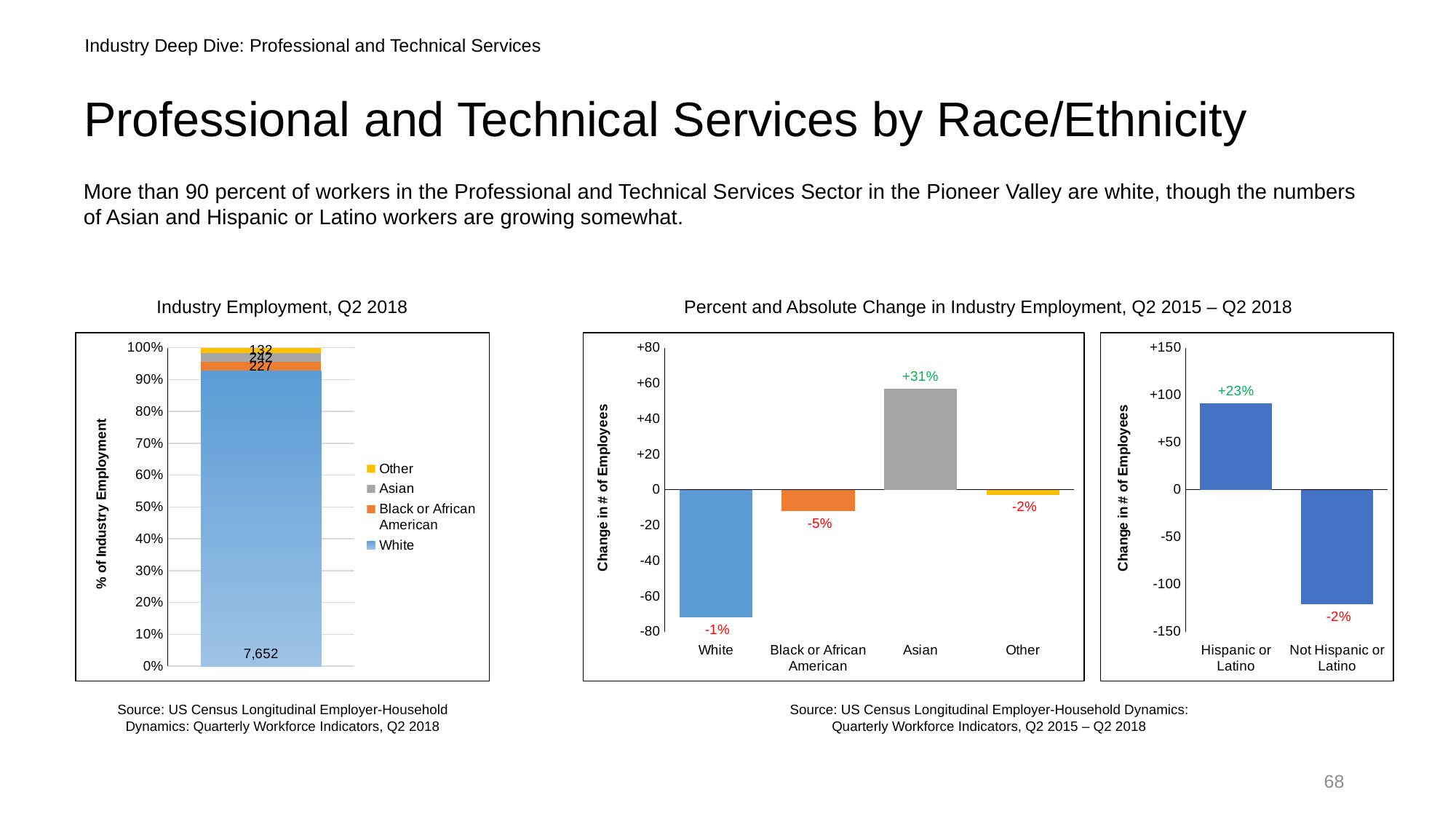
In the rightmost chart (change in employment by Hispanic or Latino status), what percent change is labeled for Hispanic or Latino? +23% In the Industry Employment, Q2 2018 chart, what is the difference between the Asian and Black or African American values? 15 How many series does the legend of the Industry Employment, Q2 2018 chart list? 4 In the middle chart (Percent and Absolute Change in Industry Employment by race), which category has the largest increase in number of employees? Asian In the Industry Employment, Q2 2018 chart, what is the value for Asian? 242 In the Industry Employment, Q2 2018 chart, how many White employees are shown? 7,652 What kind of chart is the Industry Employment, Q2 2018 chart? Stacked bar chart In the Industry Employment, Q2 2018 chart, what is the value for Black or African American? 227 In the Industry Employment, Q2 2018 chart, what is the total of the stacked bar across all four groups? 8,253 In the rightmost chart (change in employment by Hispanic or Latino status), is the change in number of employees for Not Hispanic or Latino greater or less than -100? less In the middle chart (Percent and Absolute Change in Industry Employment by race), is the change in number of employees for White greater or less than -60? less In the middle chart (Percent and Absolute Change in Industry Employment by race), what percent change is labeled for Asian? +31%